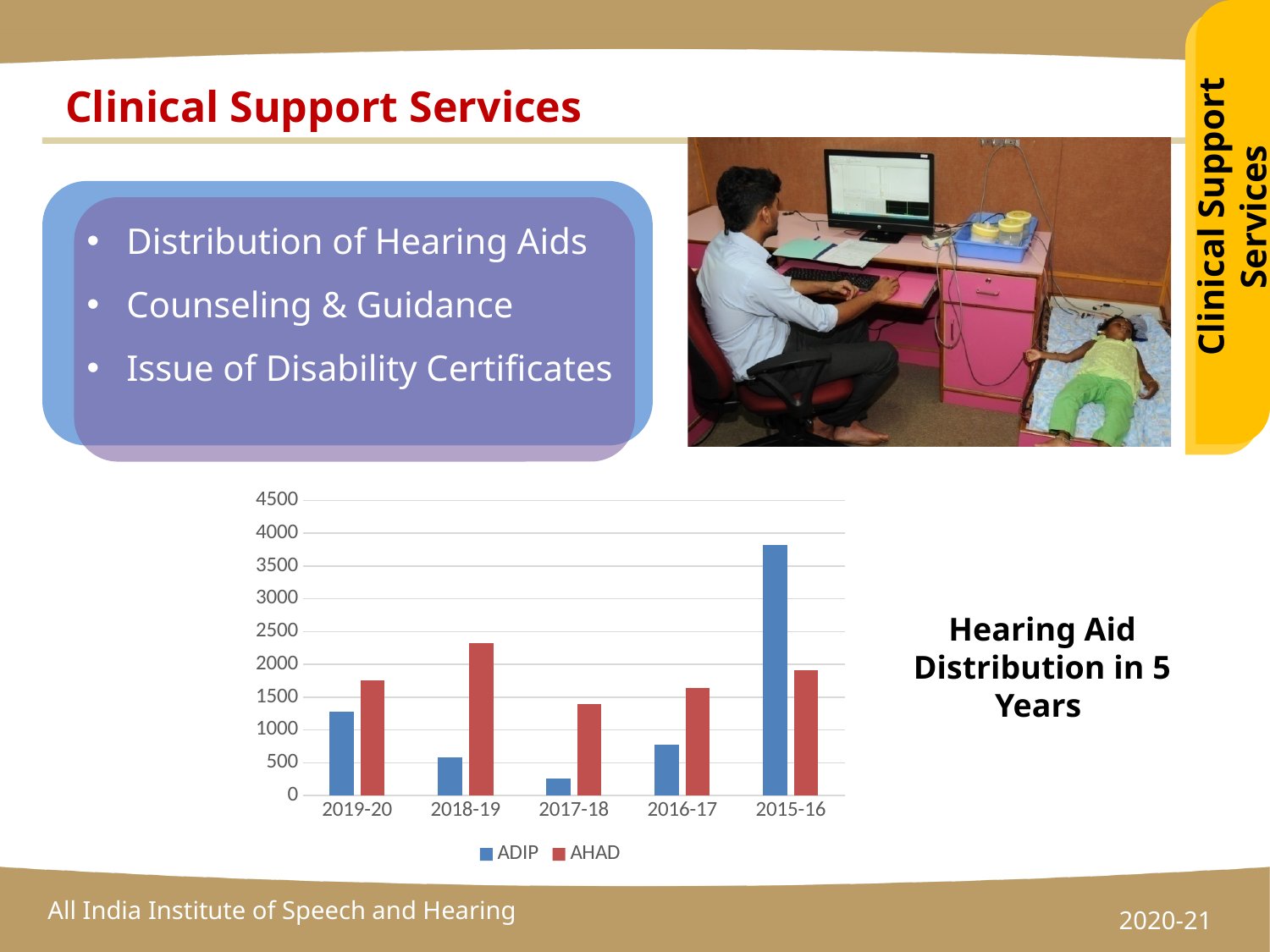
Is the AHAD value for 2018-19 greater or less than 2000? greater Is the ADIP value for 2017-18 greater or less than 500? less How many year categories are shown on the x axis of the chart? 5 Which year has the lowest AHAD value? 2017-18 Which year has the lowest ADIP value? 2017-18 Which year has the highest ADIP value? 2015-16 How many series does the chart legend list? 2 Is the ADIP value for 2015-16 greater or less than 3500? greater In 2019-20, which series has the larger value, ADIP or AHAD? AHAD What kind of chart is shown on the slide? bar chart What is the title given next to the chart? Hearing Aid Distribution in 5 Years Which year has the highest AHAD value? 2018-19